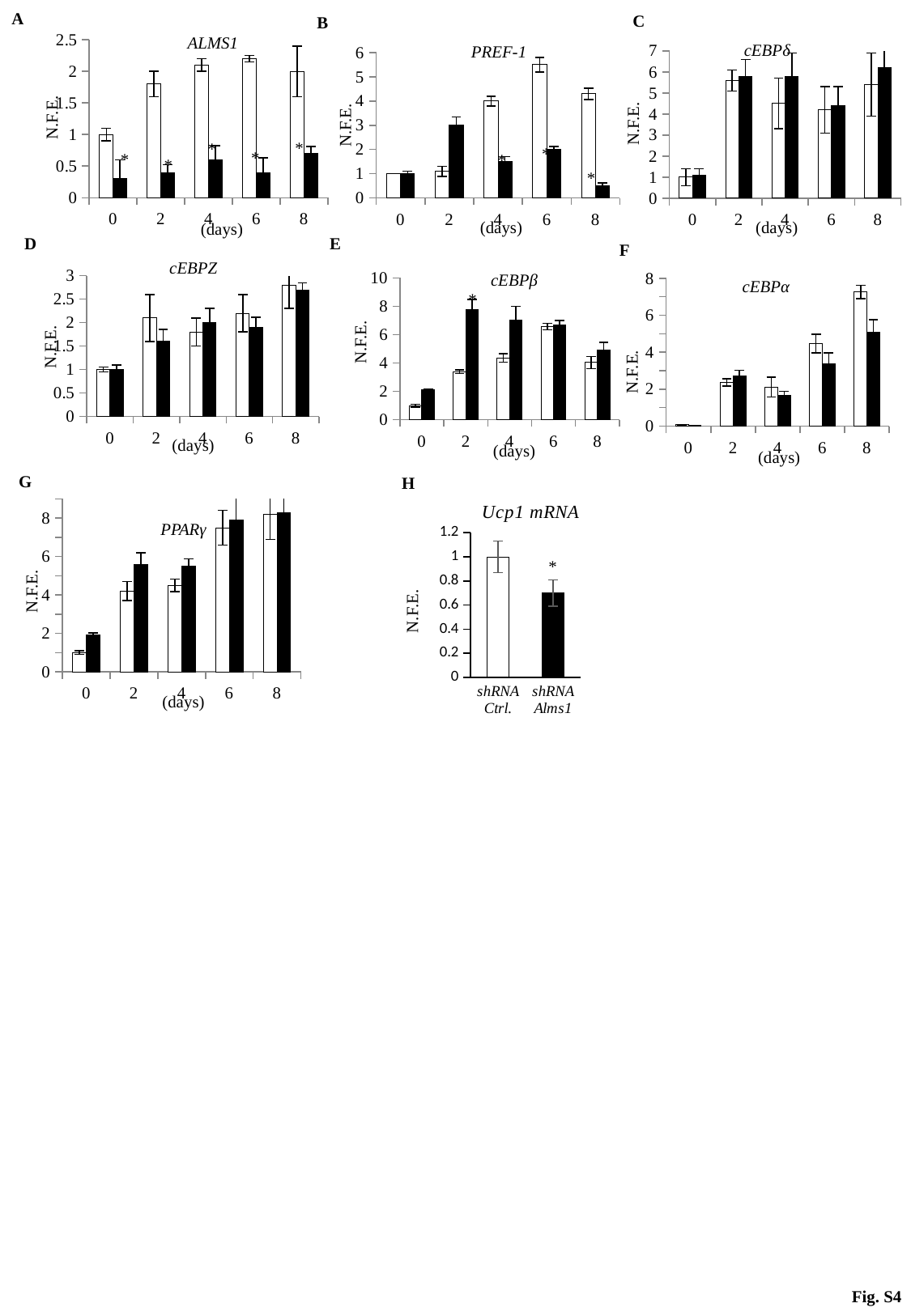
In the PREF-1 chart (panel B), at which day is the white bar highest? 6 What kind of chart is the Ucp1 mRNA chart (panel H)? bar chart In the ALMS1 chart (panel A), is the value of the black bar at day 0 greater or less than 0.5? less In the Ucp1 mRNA chart (panel H), is the value for shRNA Alms1 greater or less than 0.8? less In the Ucp1 mRNA chart (panel H), which is larger, shRNA Ctrl. or shRNA Alms1? shRNA Ctrl. In the cEBPβ chart (panel E), is the value of the black bar at day 2 greater or less than 6? greater In the cEBPβ chart (panel E), at day 0, which bar is larger, the white bar or the black bar? black bar How many day categories are shown on the x axis of the cEBPδ chart (panel C)? 5